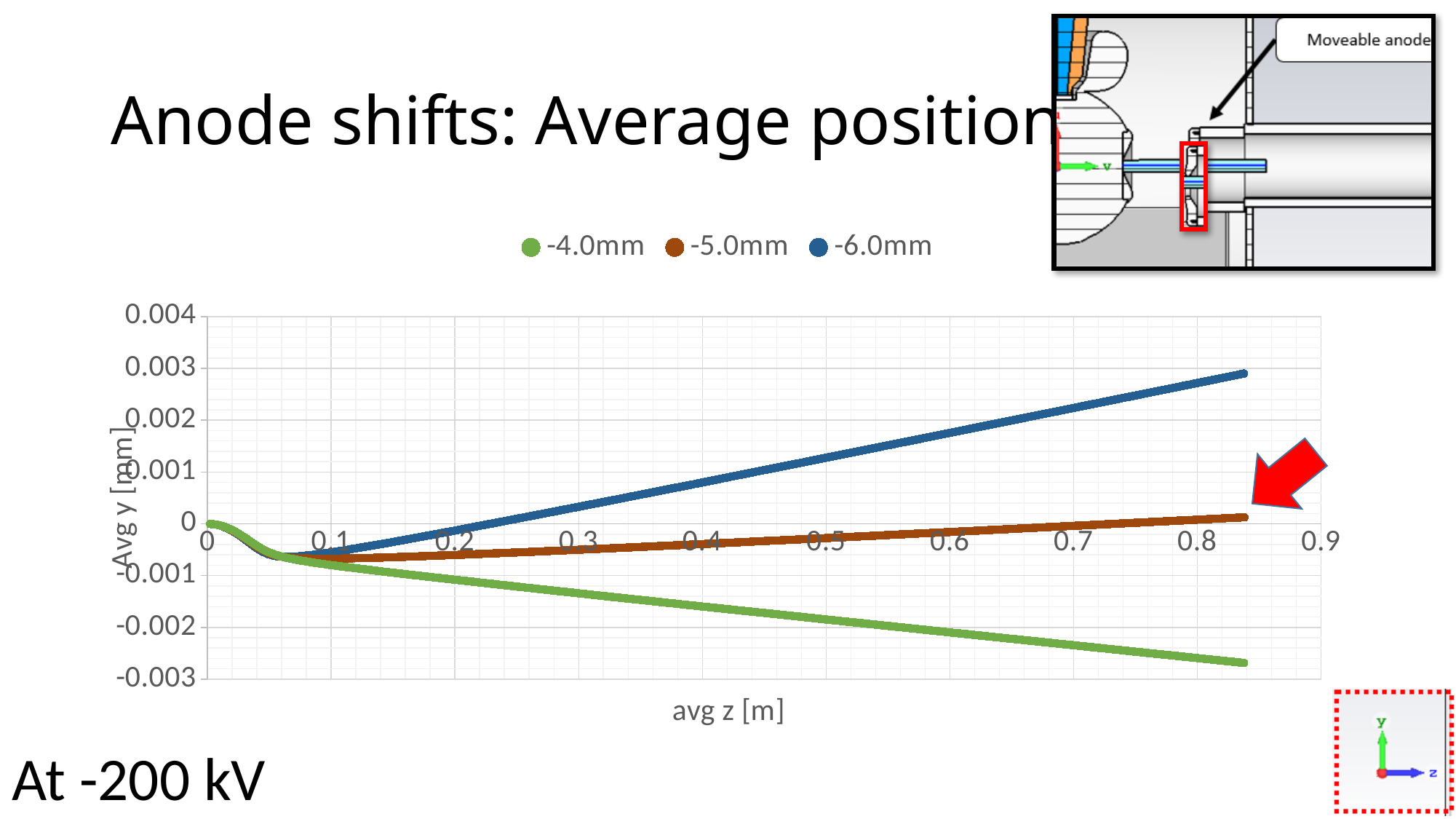
Which series reaches the lowest Avg y value at the right end of the chart? -4.0mm Is the value of the -5.0mm series at avg z = 0.8 greater or less than 0.001? less What is the label of the chart's x axis? avg z [m] How many series does the chart legend list? 3 Is the value of the -4.0mm series at avg z = 0.8 greater or less than -0.002? less Does the -6.0mm series rise or fall as avg z increases beyond 0.1 m? rise Which series reaches the highest Avg y value at the right end of the chart? -6.0mm What are the series names listed in the chart legend? -4.0mm, -5.0mm, -6.0mm Is the value of the -6.0mm series at avg z = 0.8 greater or less than 0.002? greater Does the -4.0mm series rise or fall as avg z increases beyond 0.1 m? fall What kind of chart is shown on the slide? line chart At avg z = 0.8, which series has the larger Avg y value, -5.0mm or -4.0mm? -5.0mm